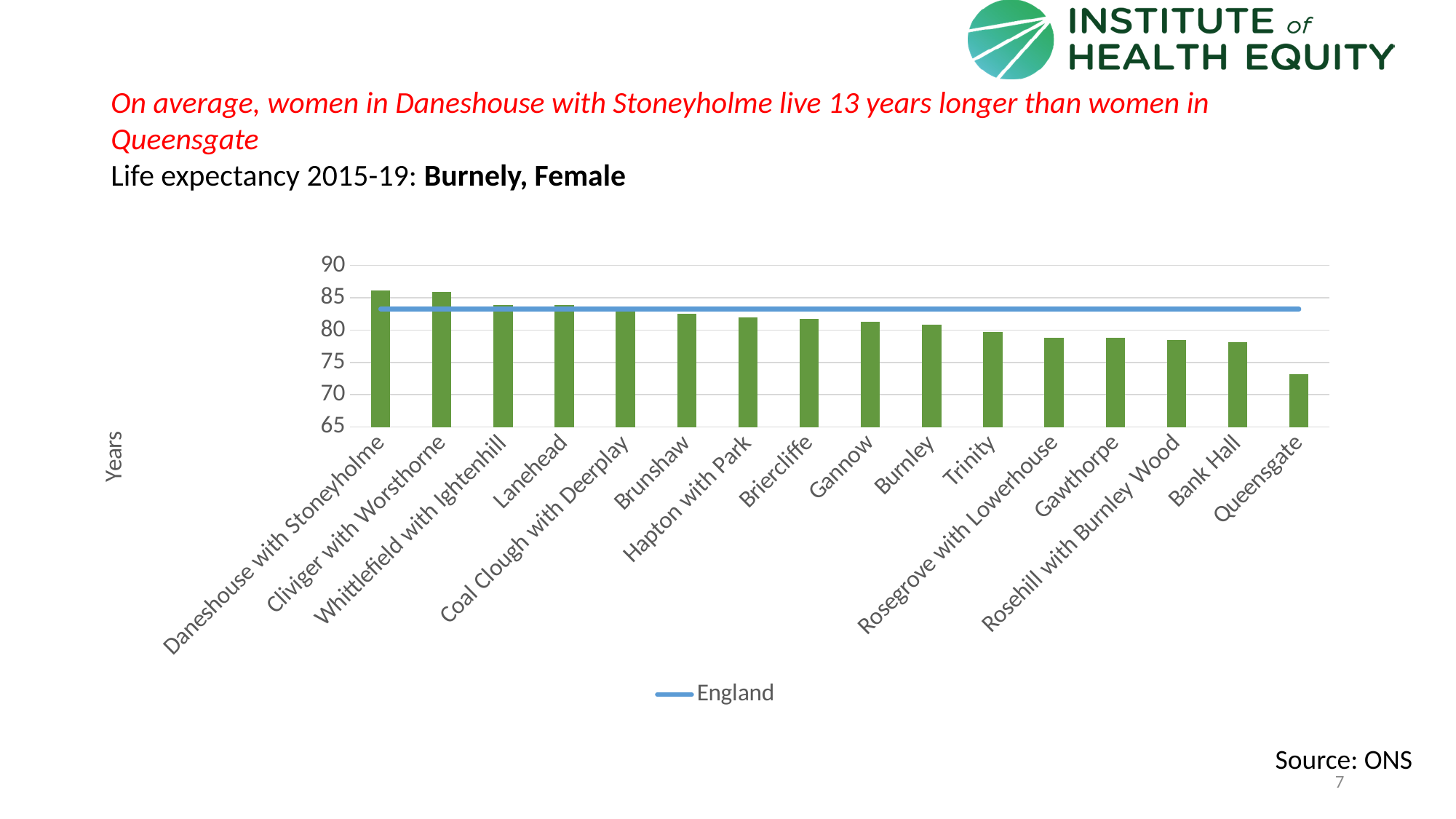
Is the value for Daneshouse with Stoneyholme greater or less than 85? greater What entry does the chart legend list? England Is the value for Bank Hall greater or less than 80? less What is the label on the vertical axis of the chart? Years Do the bar values rise or fall moving from left to right along the x axis? fall Which has the higher female life expectancy, Gannow or Gawthorpe? Gannow Which ward has the highest female life expectancy in the chart? Daneshouse with Stoneyholme Is the value for Queensgate greater or less than 75? less What kind of chart is shown on the slide? bar chart How many wards (bars) are plotted in the chart? 16 Which ward has the lowest female life expectancy in the chart? Queensgate